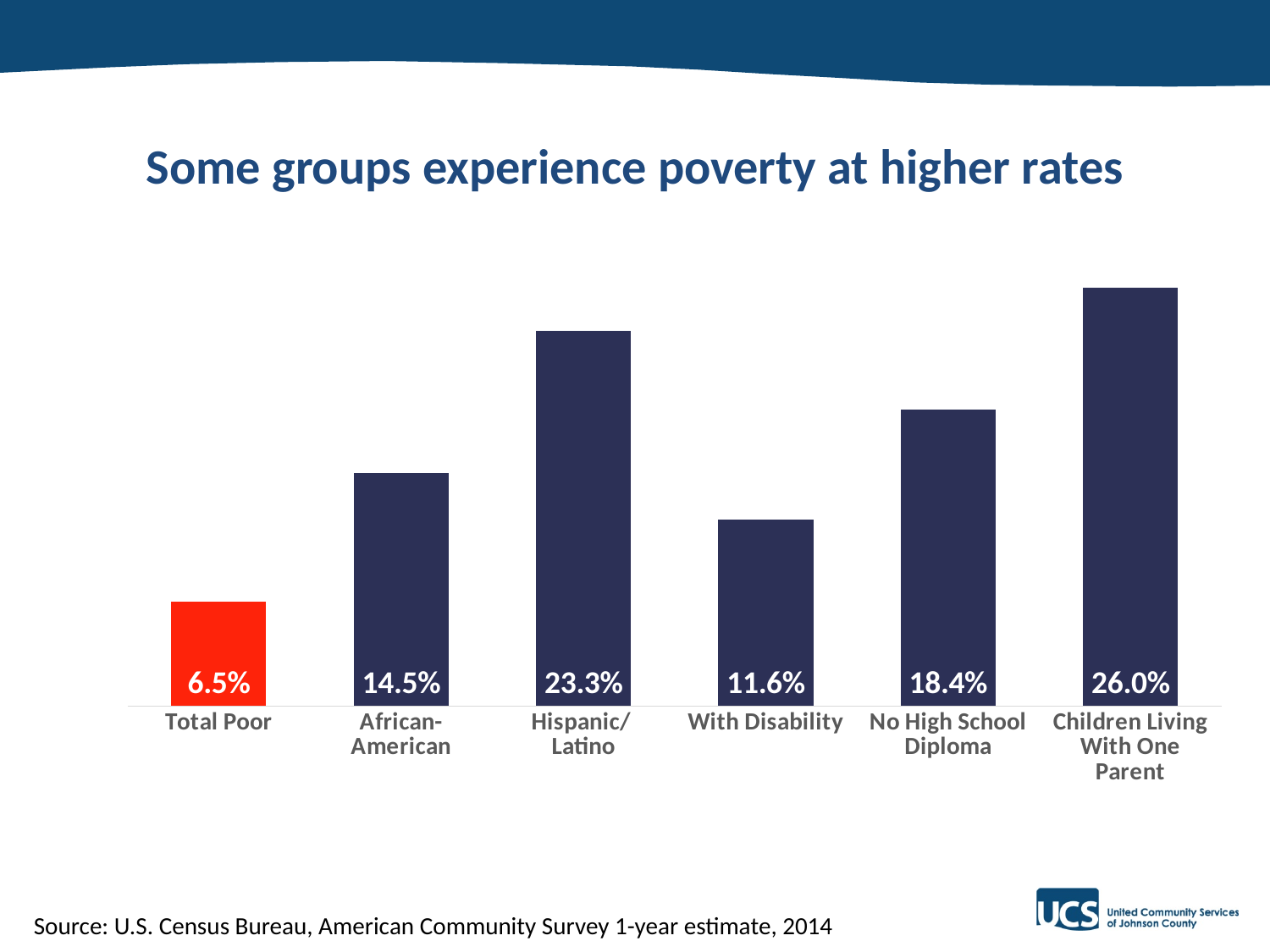
What is the poverty rate for people With Disability? 11.6% What is the poverty rate for Total Poor? 6.5% Which category has the lowest value? Total Poor How many categories are shown in the chart? 6 What is the poverty rate for those with No High School Diploma? 18.4% What is the difference between the poverty rate for Children Living With One Parent and Total Poor? 19.5% Which is larger, the value for Hispanic/Latino or the value for No High School Diploma? Hispanic/Latino What is the difference between the African-American and With Disability poverty rates? 2.9% What kind of chart is shown on the slide? Bar chart Which group has the highest poverty rate? Children Living With One Parent Which bar is coloured differently from the others? Total Poor What is the poverty rate for Hispanic/Latino? 23.3%